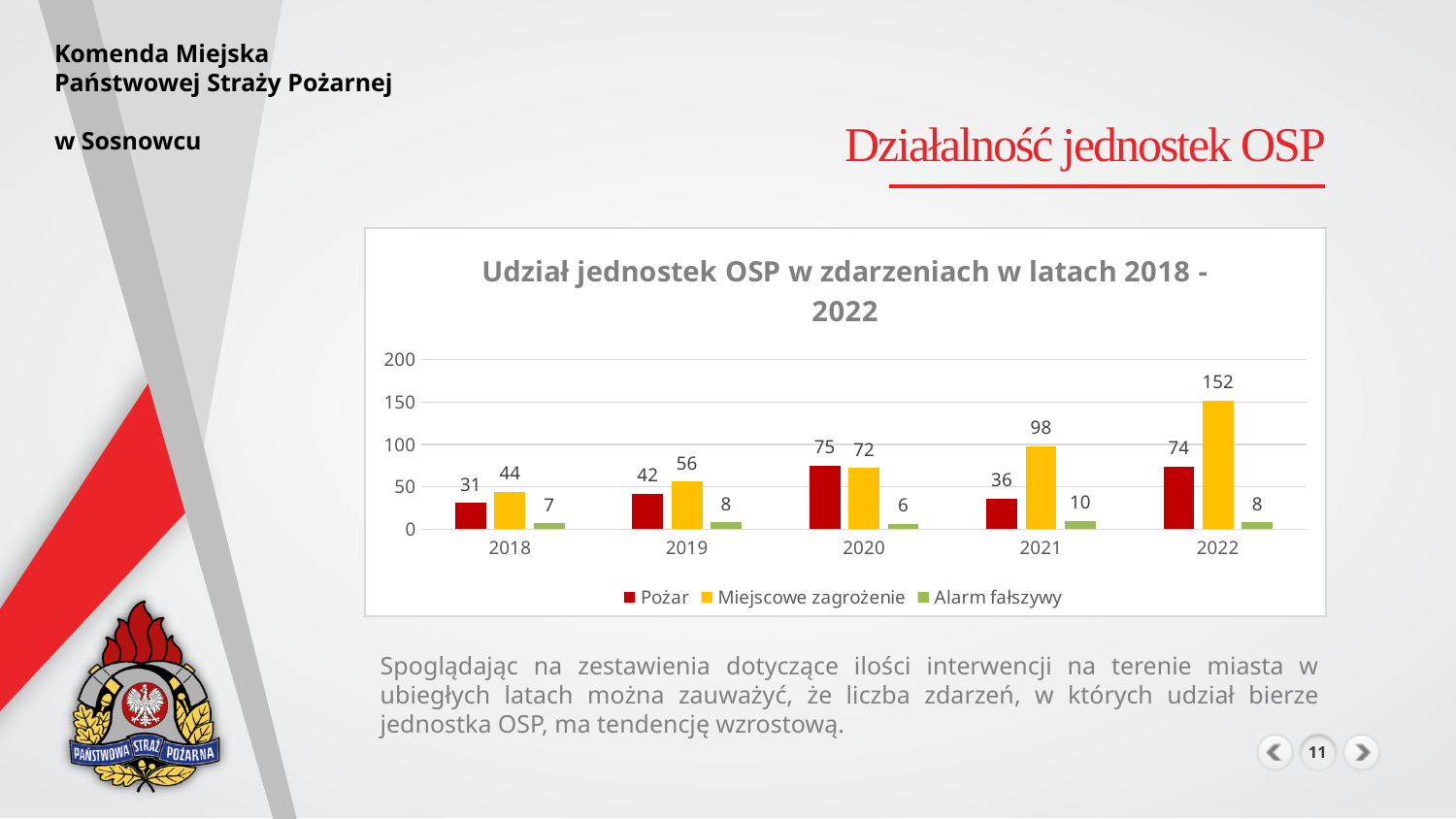
What is the value for Miejscowe zagrożenie in 2022? 152 How many years are shown on the x axis? 5 What is the title of the chart? Udział jednostek OSP w zdarzeniach w latach 2018 - 2022 Which is larger in 2020, Pożar or Miejscowe zagrożenie? Pożar What kind of chart is shown? bar chart What is the value for Alarm fałszywy in 2021? 10 How many series does the legend list? 3 Is the value for Miejscowe zagrożenie in 2022 greater or less than 150? greater In which year is the Miejscowe zagrożenie value highest? 2022 In which year is the Pożar value lowest? 2018 What is the value for Pożar in 2020? 75 What is the difference between the Miejscowe zagrożenie values for 2022 and 2021? 54